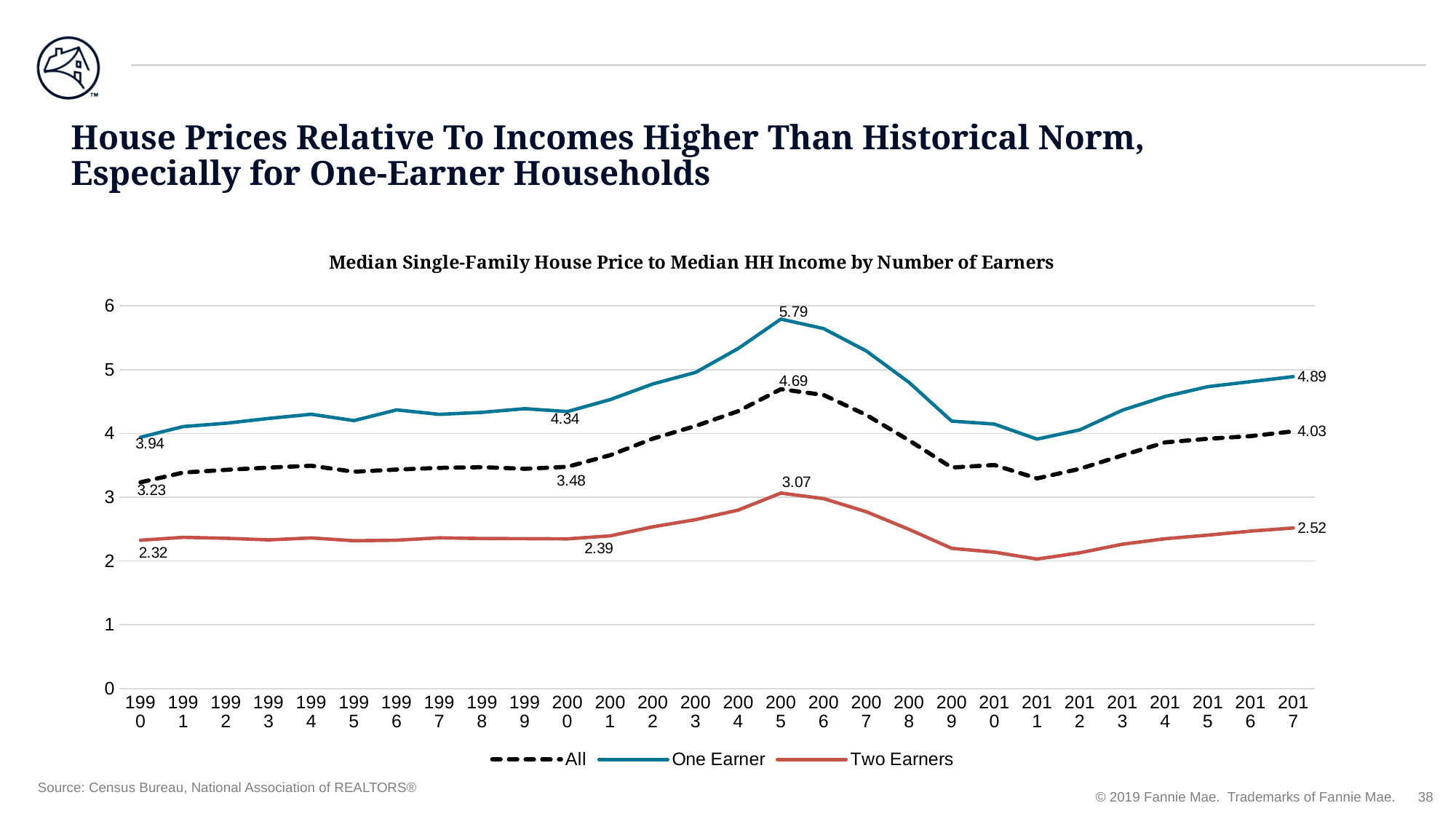
What is the All value in 2017? 4.03 What type of chart is shown on the slide? Line chart What is the One Earner value in 2000? 4.34 Which series has the highest value in 2005? One Earner Is the One Earner value in 2011 greater or less than 4? less What is the difference between the One Earner and Two Earners values in 2017? 2.37 What is the Two Earners value in 1990? 2.32 What is the One Earner value in 2005? 5.79 Which is larger, the Two Earners value in 2005 or the All value in 1990? All value in 1990 How many series does the legend list? 3 How many years are shown on the x axis? 28 By how much did the All value rise from 1990 to 2005? 1.46